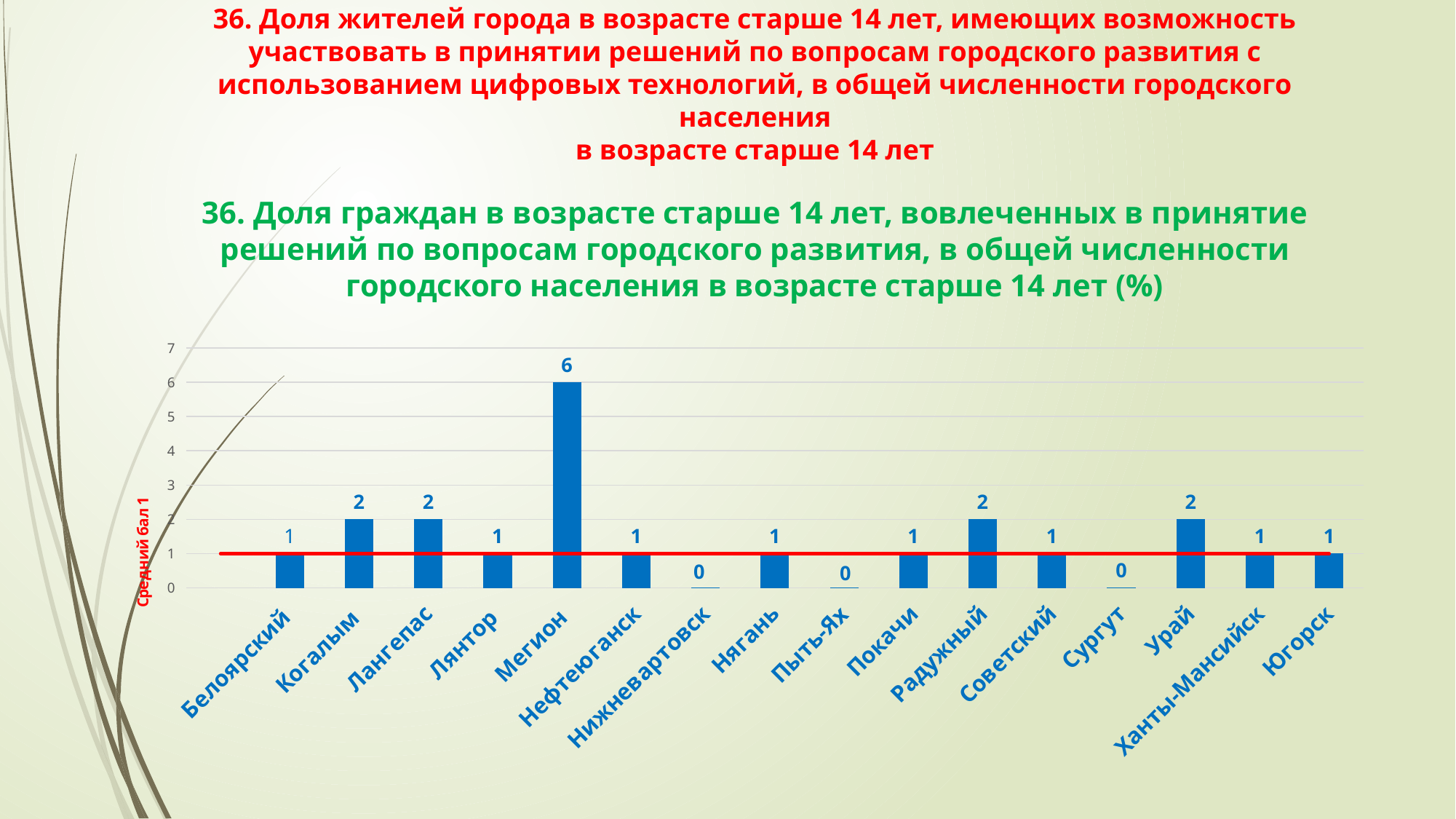
What is the value for Мегион? 6 Which is larger, the value for Радужный or the value for Советский? Радужный What is the value for Когалым? 2 Is the value for Мегион greater or less than 5? greater What does the red horizontal line represent, according to its label? Средний бал 1 Which city has the highest value? Мегион How many cities have a value of 0? 3 What kind of chart is shown on the slide? bar chart What is the value for Сургут? 0 How many cities are shown on the x axis? 16 What is the value for Ханты-Мансийск? 1 What is the difference between the values for Мегион and Урай? 4